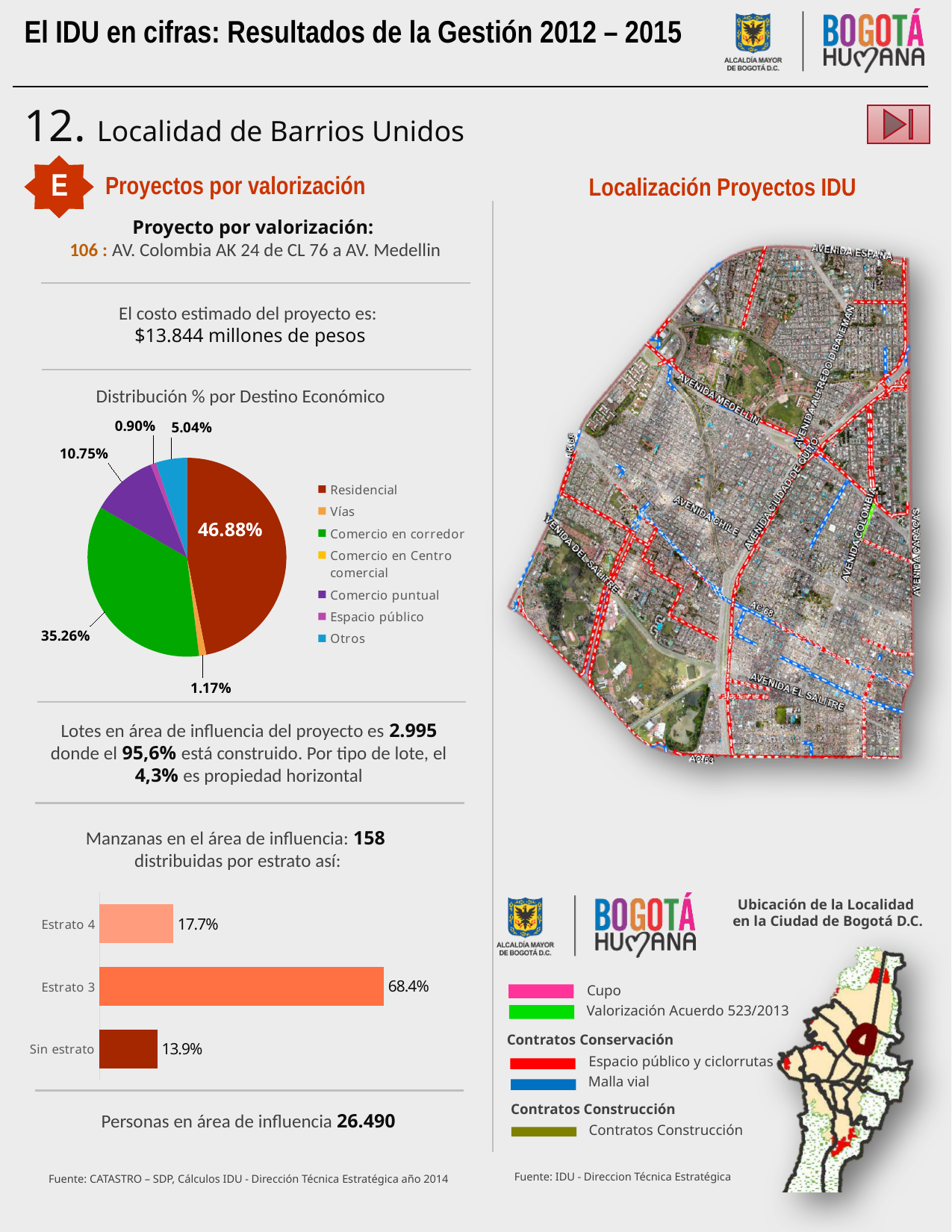
In the pie chart 'Distribución % por Destino Económico', what percentage is shown for Otros? 5.04% In the pie chart 'Distribución % por Destino Económico', what is the difference between the Residencial and Comercio en corredor shares? 11.62% In the bar chart of manzanas by estrato, what is the difference between Estrato 4 and Sin estrato? 3.8% In the pie chart 'Distribución % por Destino Económico', which is larger, Vías or Espacio público? Vías In the bar chart of manzanas by estrato, which category has the lowest value? Sin estrato In the pie chart 'Distribución % por Destino Económico', what percentage is shown for Comercio en corredor? 35.26% In the pie chart 'Distribución % por Destino Económico', what percentage is shown for Comercio puntual? 10.75% In the pie chart 'Distribución % por Destino Económico', what percentage is shown for Residencial? 46.88% What type of chart is used to show the manzanas distributed by estrato? Bar chart In the pie chart 'Distribución % por Destino Económico', which category has the largest share? Residencial In the pie chart 'Distribución % por Destino Económico', how many entries does the legend list? 7 In the bar chart of manzanas by estrato, what percentage is shown for Estrato 3? 68.4%